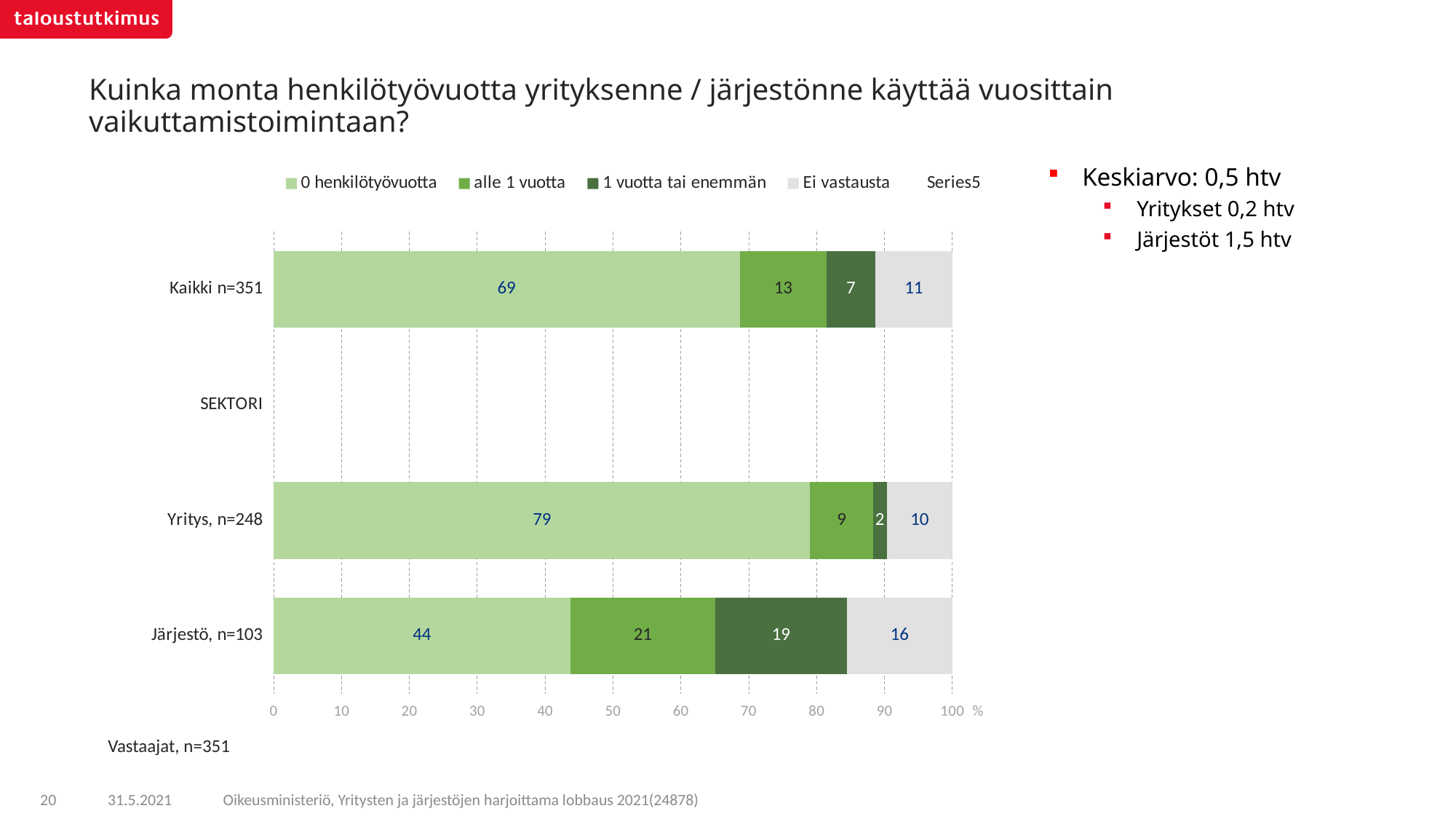
Which bar has the highest value for '0 henkilötyövuotta'? Yritys, n=248 What is the value for '0 henkilötyövuotta' in the 'Kaikki n=351' bar? 69 What is the value for '1 vuotta tai enemmän' in the 'Yritys, n=248' bar? 2 What is the total of the 'Kaikki n=351' stacked bar? 100 What is the value for 'Ei vastausta' in the 'Järjestö, n=103' bar? 16 Which bar has the lowest value for '1 vuotta tai enemmän'? Yritys, n=248 What is the value for 'alle 1 vuotta' in the 'Järjestö, n=103' bar? 21 Which is larger: the 'alle 1 vuotta' value for 'Kaikki n=351' or for 'Järjestö, n=103'? Järjestö, n=103 What is the difference between the '0 henkilötyövuotta' values for 'Yritys, n=248' and 'Järjestö, n=103'? 35 How many series does the legend list? 5 What is the average (Keskiarvo) stated in the text next to the chart? 0,5 htv What kind of chart is shown on the slide? stacked bar chart